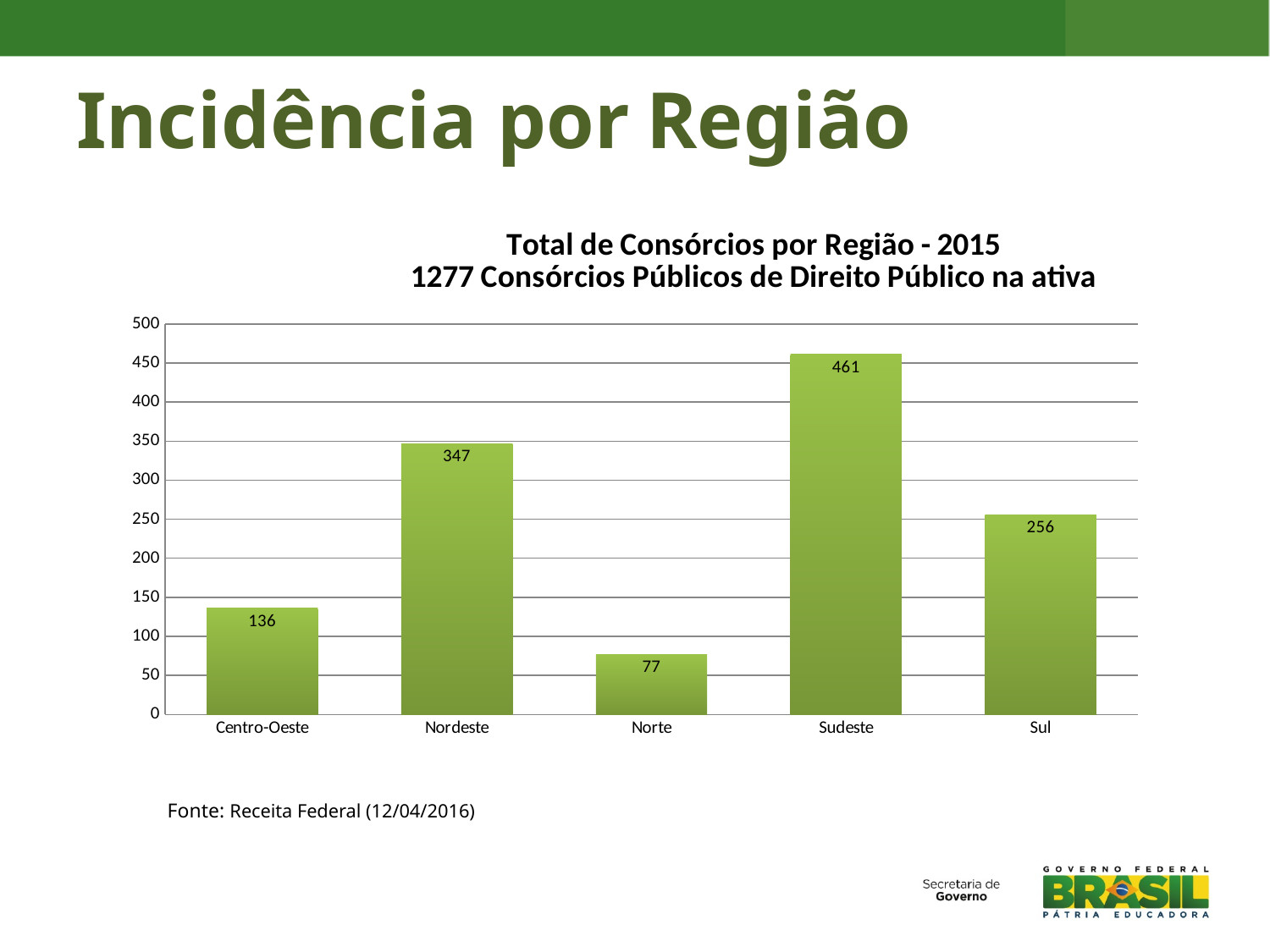
What is the difference between the values for Sul and Centro-Oeste? 120 How many regions are shown on the chart? 5 What kind of chart is shown on the slide? bar chart Which region has the highest value? Sudeste What is the difference between the values for Sudeste and Nordeste? 114 Is the value for Sul greater or less than 200? greater What is the value for Centro-Oeste? 136 Which is larger, the value for Nordeste or the value for Sul? Nordeste Which region has the lowest value? Norte What is the value for Sudeste? 461 What is the value for Norte? 77 What is the title of the chart? Total de Consórcios por Região - 2015 1277 Consórcios Públicos de Direito Público na ativa